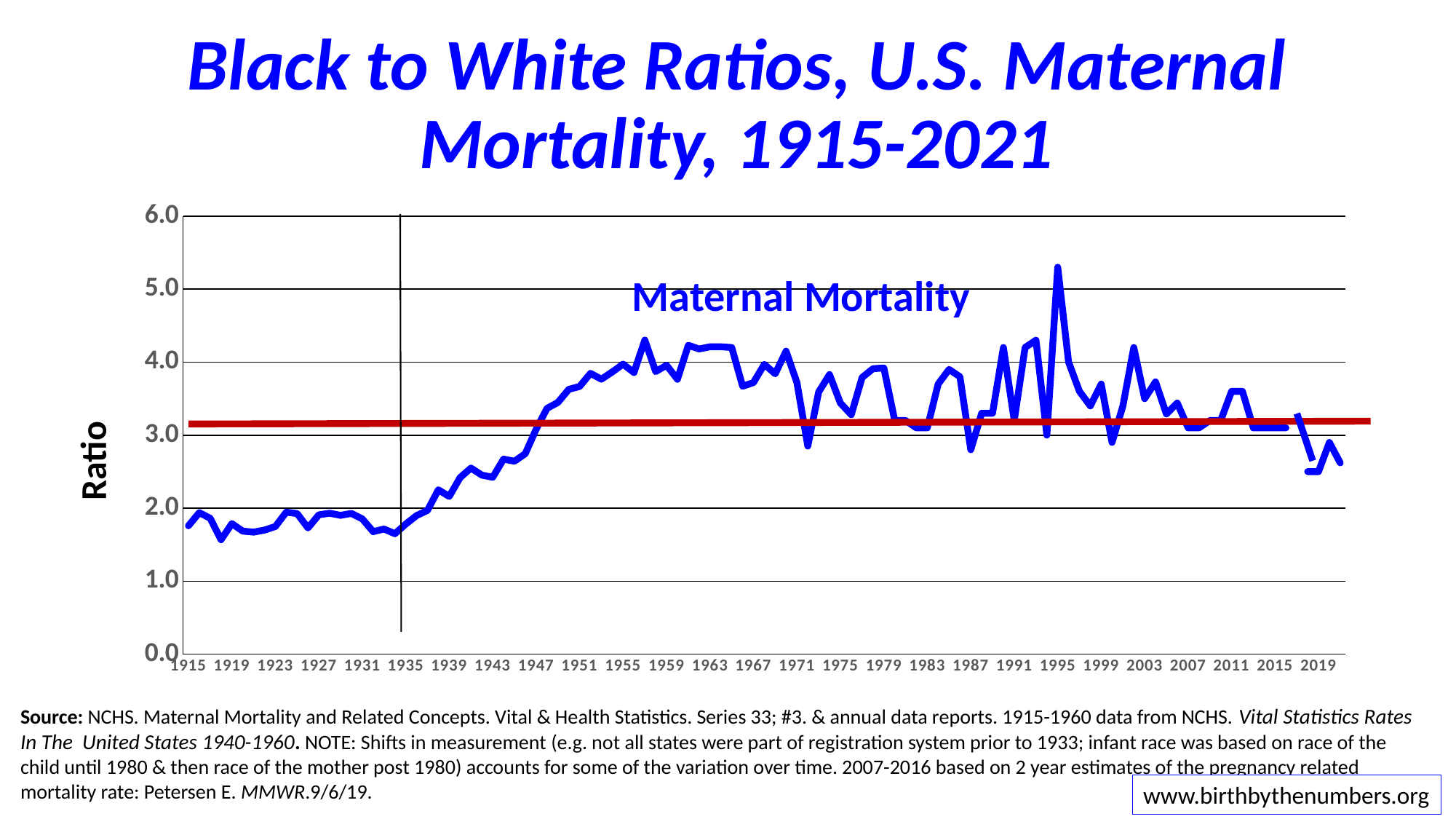
Is the ratio for 1943 greater or less than 3.0? less Is the ratio for 2019 greater or less than 3.0? less What kind of chart is shown on the slide? line chart Is the ratio for 1995 greater or less than 5.0? greater Between 1935 and 1947, does the ratio rise or fall? rise What is the title of the chart? Black to White Ratios, U.S. Maternal Mortality, 1915-2021 Between 2011 and 2019, does the ratio rise or fall? fall What label is printed on the vertical axis of the chart? Ratio In which year does the ratio reach its highest value? 1995 Which year has the larger ratio, 1915 or 1995? 1995